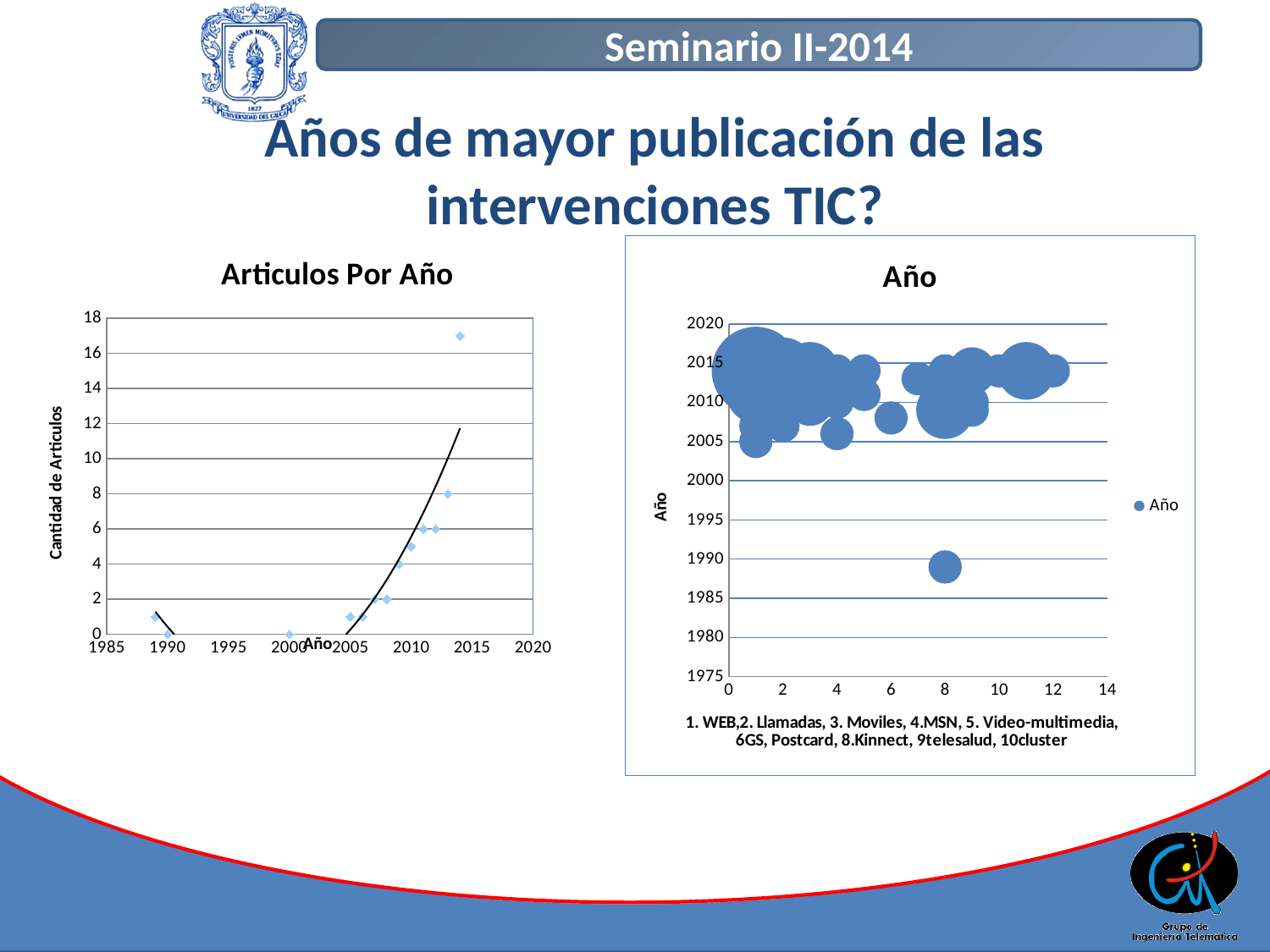
What kind of chart is the 'Año' chart on the right of the slide? bubble chart In the 'Articulos Por Año' chart, what is the label of the vertical axis? Cantidad de Articulos In the 'Articulos Por Año' chart, is the value for the highest point (around 2014) greater or less than 16? greater What kind of chart is the 'Articulos Por Año' chart on the left? scatter chart What is the title of the chart on the left of the slide? Articulos Por Año In the 'Articulos Por Año' chart, is the value for the point at 2013 greater or less than 10? less In the 'Año' chart on the right, what is the highest value shown on the horizontal axis? 14 In the 'Año' chart on the right, is the year of the lowest bubble greater or less than 1995? less How many series does the legend of the 'Año' chart on the right list? 1 In the 'Articulos Por Año' chart, do the values generally rise or fall as the year increases from 2005 to 2014? rise In the 'Articulos Por Año' chart, which is larger: the value for 2014 or the value for 2013? 2014